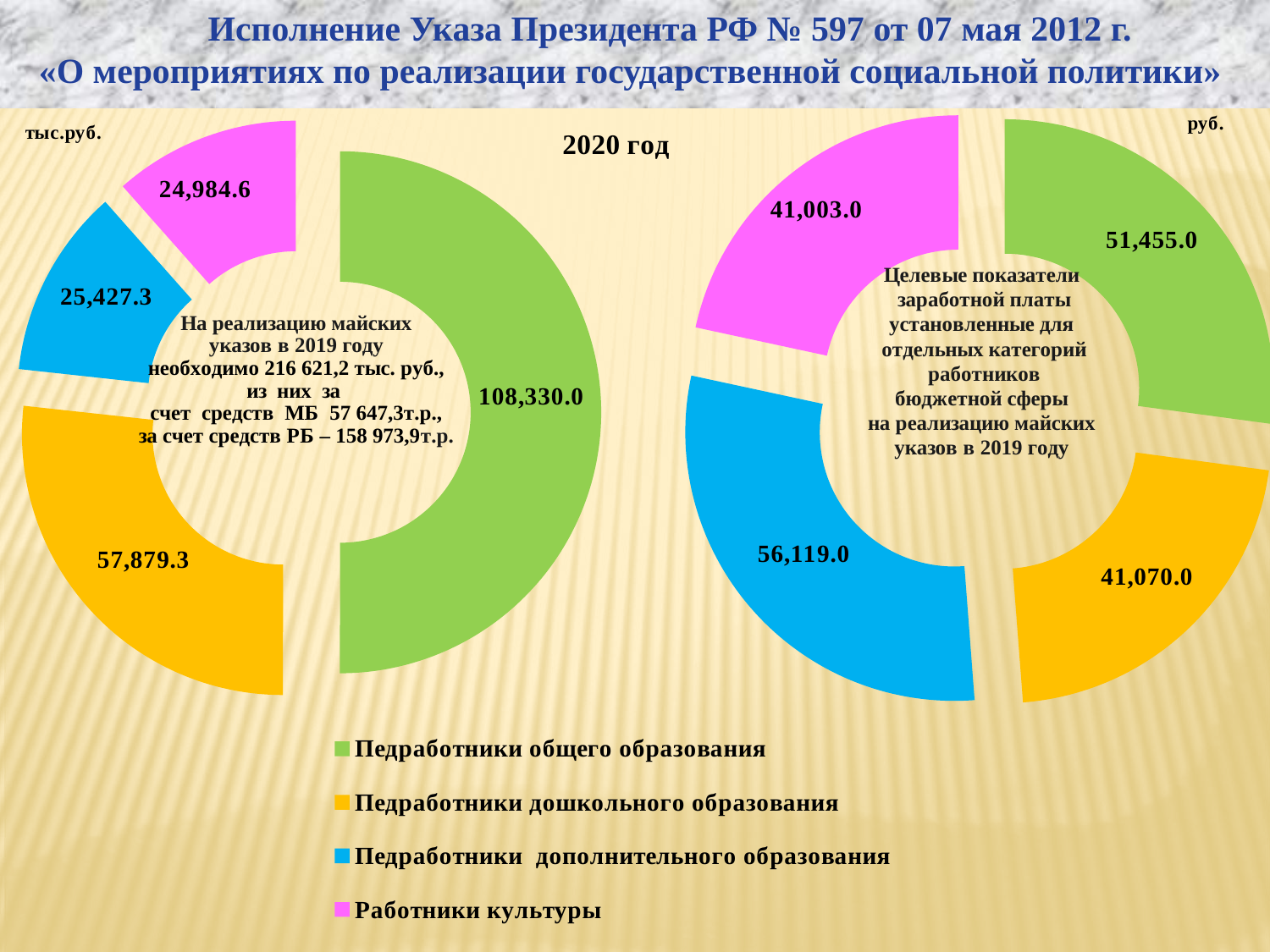
In the left chart, what is the difference between the values for Педработники общего образования and Педработники дошкольного образования? 50,450.7 In the left chart, which category has the lowest value? Работники культуры What is the total of all values in the left chart? 216,621.2 In the left chart, what is the value for Педработники общего образования? 108,330.0 In the right chart, what is the value for Педработники дополнительного образования? 56,119.0 In the left chart, which category has the highest value? Педработники общего образования What kind of chart is the left chart? doughnut chart In the right chart, what is the value for Работники культуры? 41,003.0 In the right chart, which category has the highest value? Педработники дополнительного образования How many categories does the legend list? 4 In the right chart, which is larger: the value for Педработники дополнительного образования or Педработники общего образования? Педработники дополнительного образования In the left chart, what is the value for Педработники дошкольного образования? 57,879.3